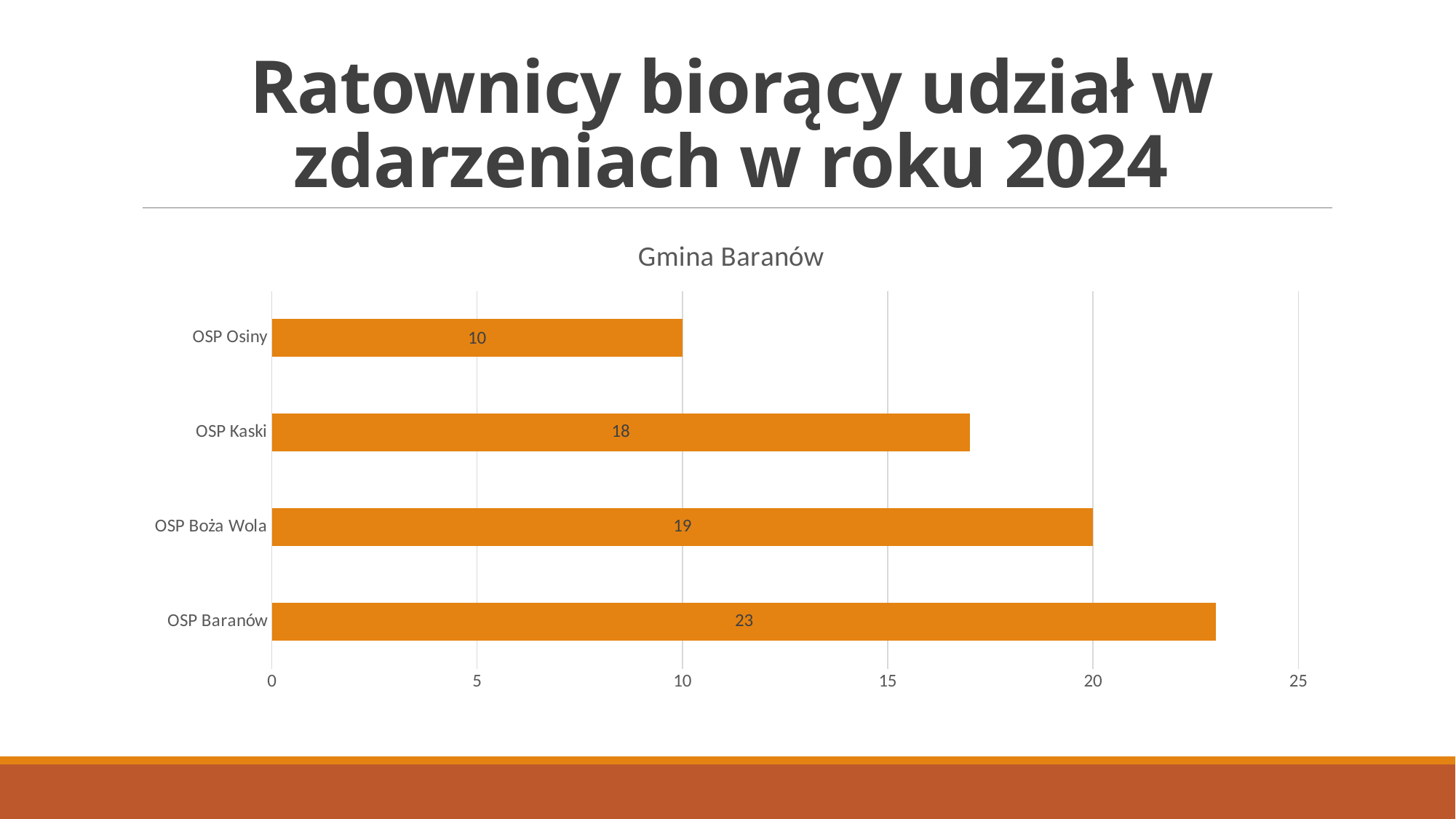
What is the value for OSP Boża Wola? 19 What is the value for OSP Kaski? 18 What is the value for OSP Baranów? 23 What is the title of the chart? Gmina Baranów How many categories are shown in the chart? 4 Is the value for OSP Baranów greater or less than 20? greater Which category has the highest value? OSP Baranów Which category has the lowest value? OSP Osiny What is the difference between the values for OSP Baranów and OSP Osiny? 13 Which is larger, the value for OSP Boża Wola or the value for OSP Kaski? OSP Boża Wola What kind of chart is shown on the slide? bar chart What is the value for OSP Osiny? 10